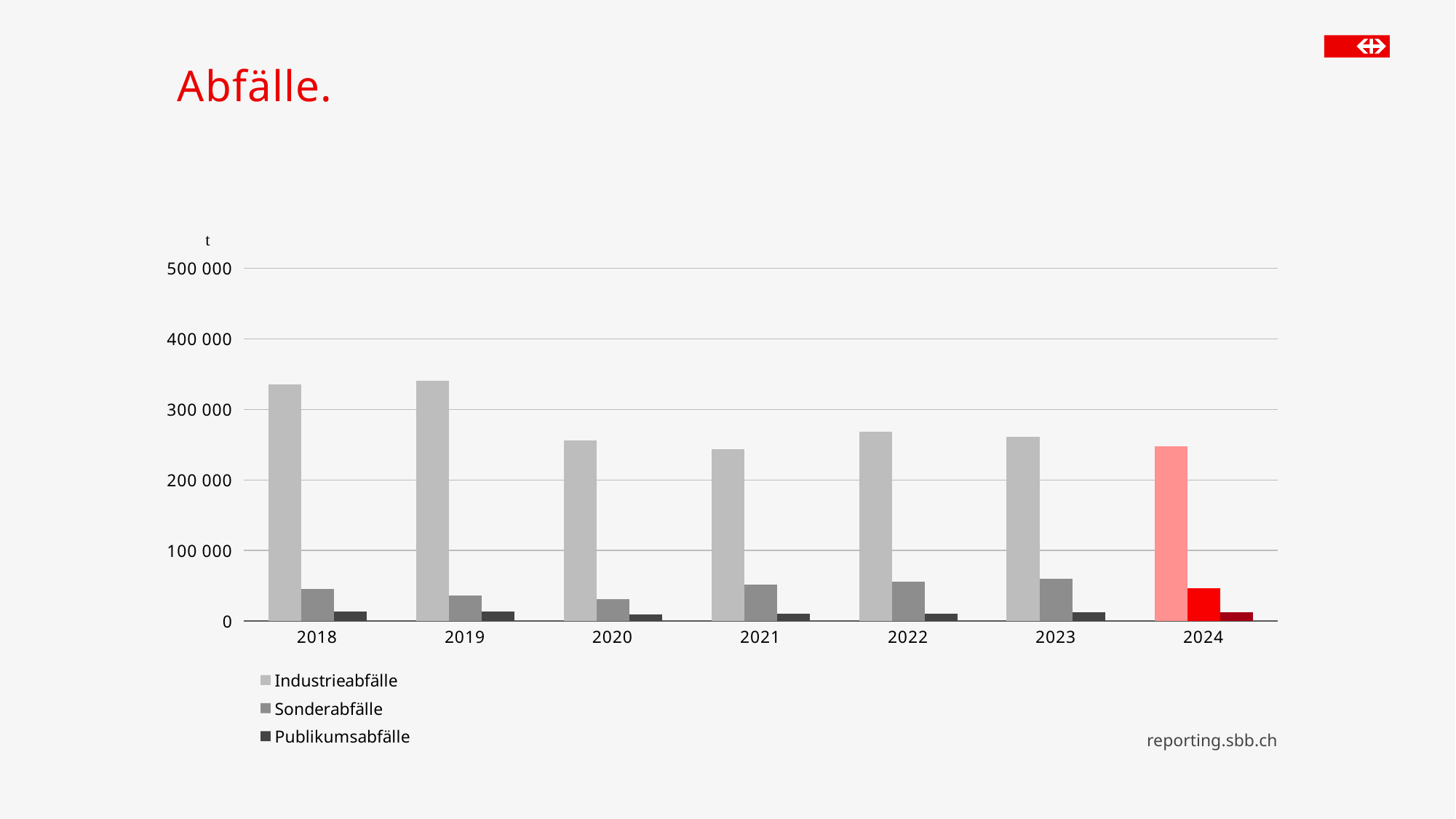
How many series does the legend list? 3 What unit is shown on the y axis? t What is the title of the chart? Abfälle. Is the value for Sonderabfälle in 2023 greater or less than 100 000? less Which is larger, Sonderabfälle in 2021 or Sonderabfälle in 2020? 2021 Is the value for Industrieabfälle in 2020 greater or less than 300 000? less Overall, do the Industrieabfälle values rise or fall from 2018 to 2024? fall Is the value for Industrieabfälle in 2018 greater or less than 300 000? greater What kind of chart is shown on the slide? bar chart How many years are shown on the x axis? 7 Which is larger, Industrieabfälle in 2019 or Industrieabfälle in 2020? 2019